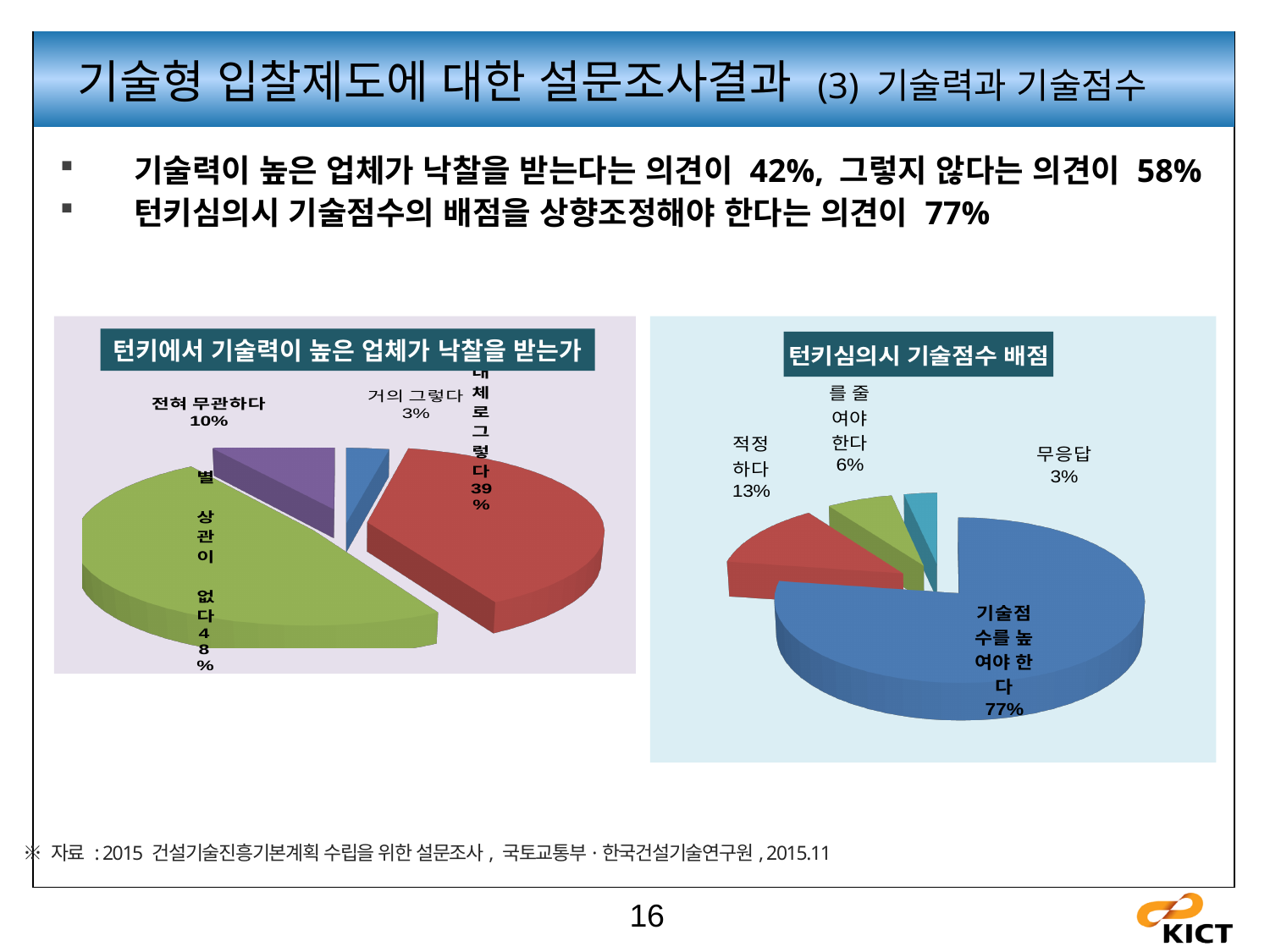
In the left chart '턴키에서 기술력이 높은 업체가 낙찰을 받는가', which response has the largest share? 별 상관이 없다 In the right chart '턴키심의시 기술점수 배점', which is larger: '적정하다' or '무응답'? 적정하다 In the right chart '턴키심의시 기술점수 배점', what percentage is shown for '기술점수를 높여야 한다'? 77% In the right chart '턴키심의시 기술점수 배점', what percentage is shown for '적정하다'? 13% In the left chart '턴키에서 기술력이 높은 업체가 낙찰을 받는가', what is the difference between '별 상관이 없다' and '대체로 그렇다'? 9% How many slices does the left chart '턴키에서 기술력이 높은 업체가 낙찰을 받는가' have? 4 In the left chart '턴키에서 기술력이 높은 업체가 낙찰을 받는가', what percentage is shown for '별 상관이 없다'? 48% In the right chart '턴키심의시 기술점수 배점', what is the difference between '기술점수를 높여야 한다' and '적정하다'? 64% In the left chart '턴키에서 기술력이 높은 업체가 낙찰을 받는가', which response has the smallest share? 거의 그렇다 In the right chart '턴키심의시 기술점수 배점', which response has the smallest share? 무응답 What type of chart is the right chart '턴키심의시 기술점수 배점'? Pie chart In the left chart '턴키에서 기술력이 높은 업체가 낙찰을 받는가', what percentage is shown for '전혀 무관하다'? 10%